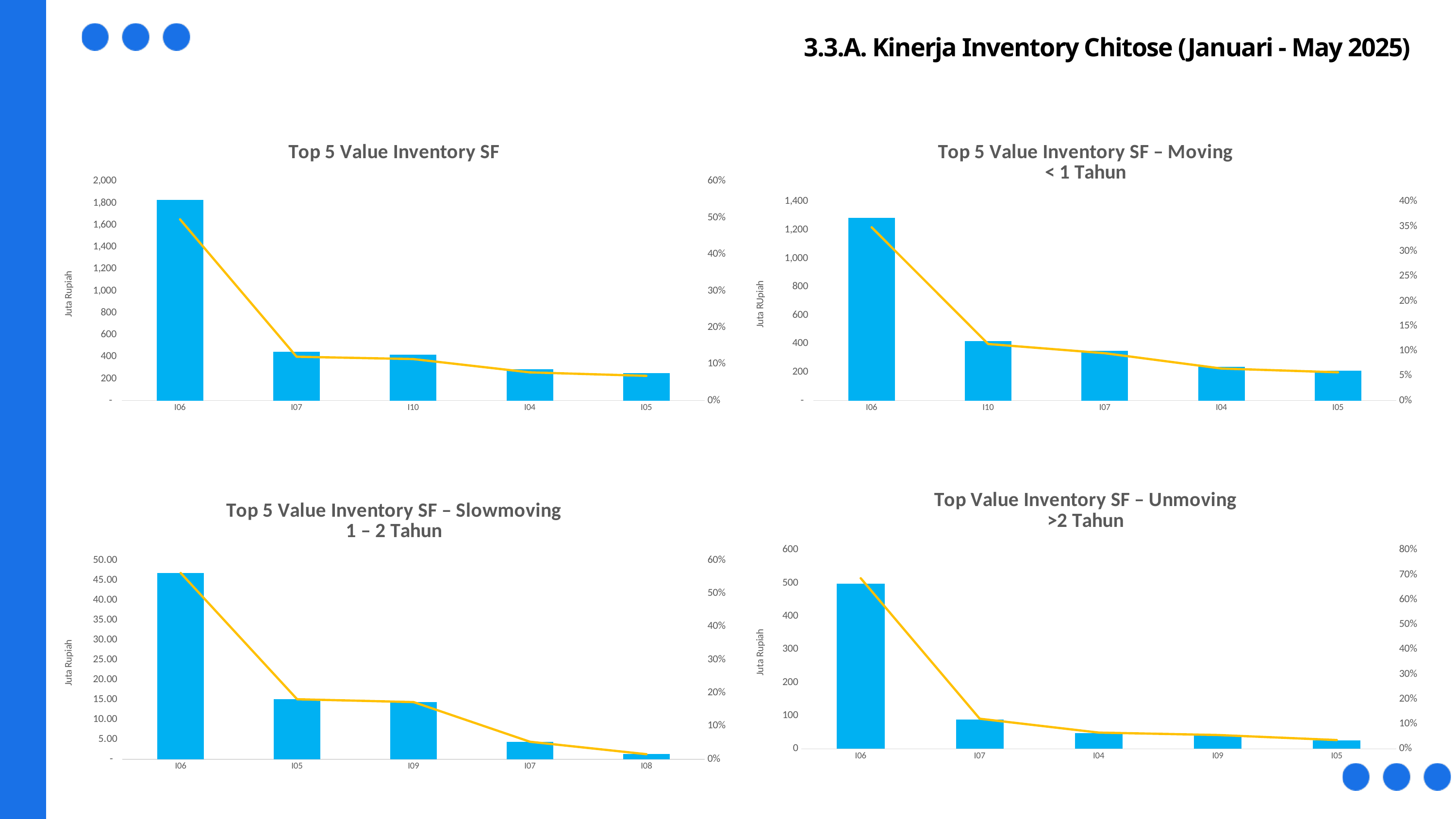
On the 'Top 5 Value Inventory SF' chart, how many categories are shown on the x axis? 5 On the 'Top 5 Value Inventory SF – Moving < 1 Tahun' chart, is the bar value for I06 greater or less than 1,000? greater On the 'Top Value Inventory SF – Unmoving >2 Tahun' chart, which bar is larger, I07 or I04? I07 On the 'Top Value Inventory SF – Unmoving >2 Tahun' chart, is the bar value for I07 greater or less than 100? less On the 'Top 5 Value Inventory SF' chart, which category has the highest bar? I06 On the 'Top 5 Value Inventory SF – Moving < 1 Tahun' chart, which category has the highest bar? I06 On the 'Top 5 Value Inventory SF – Slowmoving 1 – 2 Tahun' chart, is the bar value for I06 greater or less than 40.00? greater On the 'Top 5 Value Inventory SF – Slowmoving 1 – 2 Tahun' chart, do the bar values rise or fall from left to right? fall What kind of chart is the 'Top Value Inventory SF – Unmoving >2 Tahun' chart? bar chart with a line On the 'Top 5 Value Inventory SF – Slowmoving 1 – 2 Tahun' chart, which category has the lowest bar? I08 On the 'Top 5 Value Inventory SF' chart, which bar is larger, I06 or I07? I06